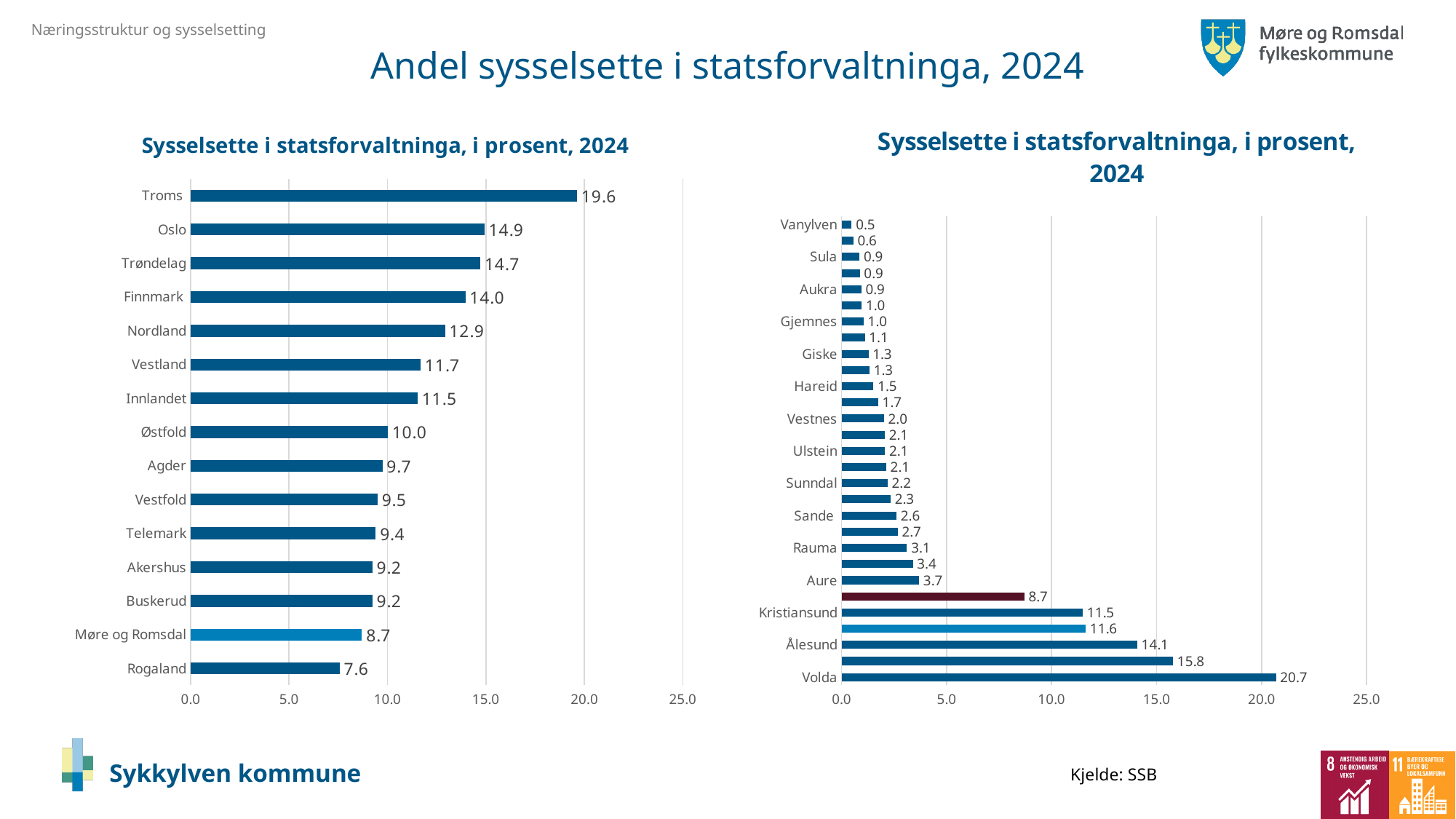
In the left chart, which category has the lowest value? Rogaland In the left chart, what is the value for Troms? 19.6 In the right chart, what is the difference between Ålesund and Kristiansund? 2.6 In the left chart, what is the value for Møre og Romsdal? 8.7 In the right chart, what is the value for Volda? 20.7 How many categories are shown in the left chart? 15 In the right chart, which category has the highest value? Volda In the left chart, what is the difference between Oslo and Trøndelag? 0.2 What kind of chart is the left chart? Bar chart In the left chart, which is larger, Nordland or Vestland? Nordland In the right chart, is the value for Aure greater or less than 5.0? less In the right chart, what is the value for Kristiansund? 11.5